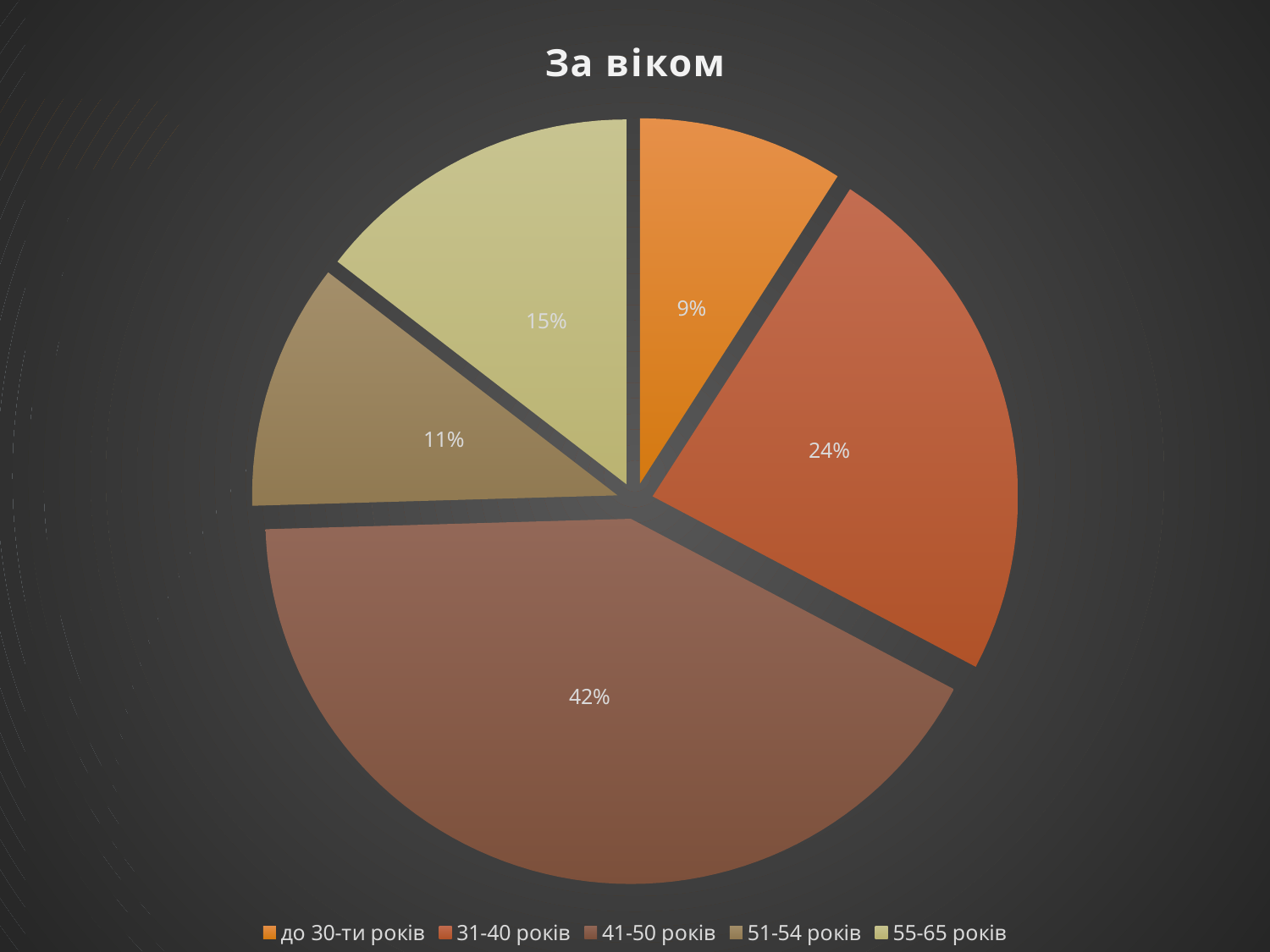
What kind of chart is shown on the slide? pie chart Which age group has the smallest slice of the pie? до 30-ти років What share of the pie is the slice for 31-40 років? 24% Which slice is larger: 51-54 років or 55-65 років? 55-65 років How many slices does the pie chart have? 5 Which age group has the largest slice of the pie? 41-50 років What share of the pie is the slice for 55-65 років? 15% What share of the pie is the slice for 41-50 років? 42% Which legend entry is shown in the lightest (pale yellow-green) colour? 55-65 років What is the title of the chart? За віком What is the difference in percentage points between the 41-50 років slice and the 31-40 років slice? 18